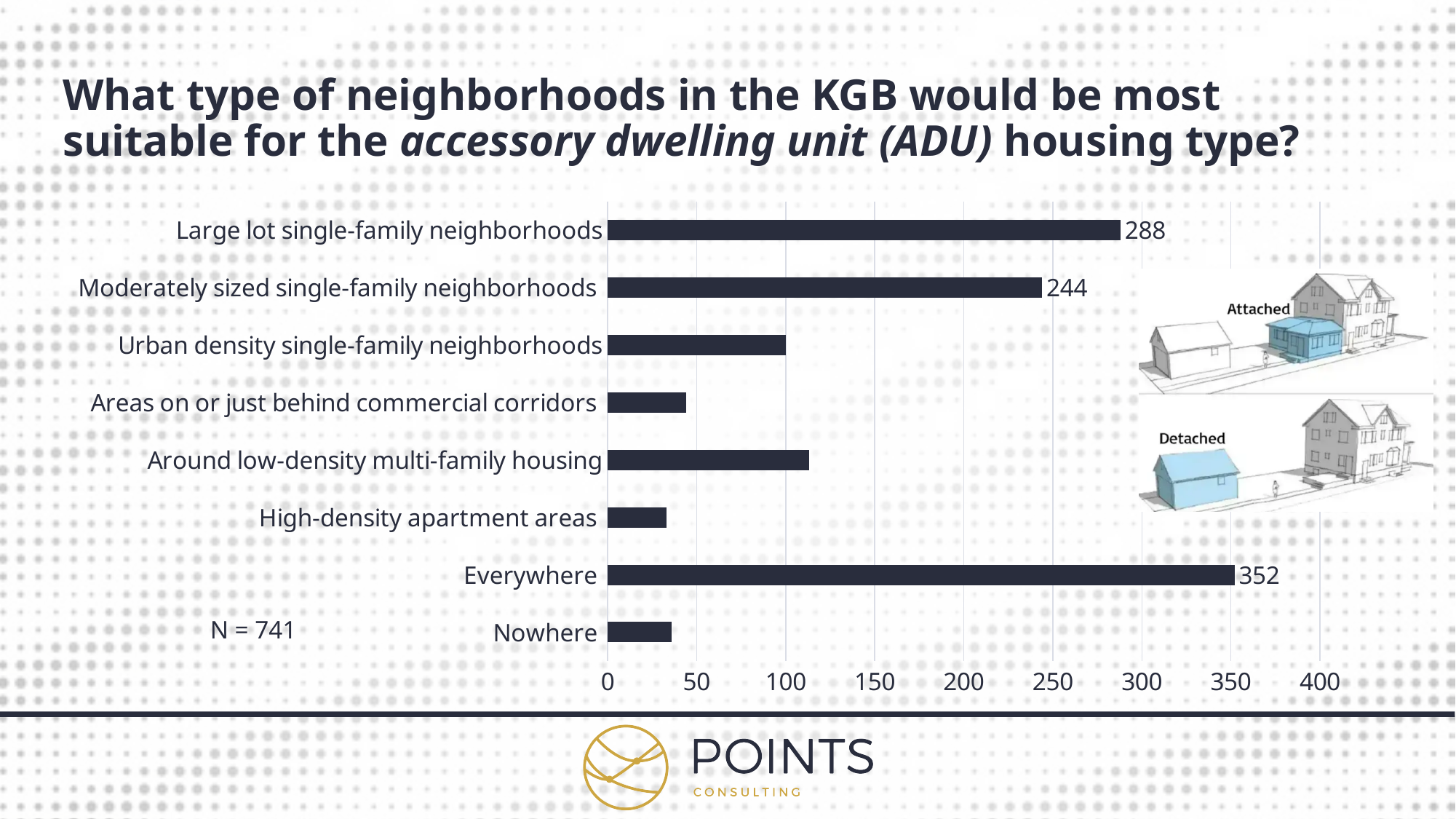
What is the value for Everywhere? 352 What is the value for Large lot single-family neighborhoods? 288 Which is larger, the value for Around low-density multi-family housing or the value for Areas on or just behind commercial corridors? Around low-density multi-family housing What is the sample size (N) stated on the slide? N = 741 What kind of chart is shown on the slide? bar chart Is the value for Areas on or just behind commercial corridors greater or less than 100? less Is the value for Urban density single-family neighborhoods greater or less than 150? less What is the difference between the values for Large lot single-family neighborhoods and Moderately sized single-family neighborhoods? 44 What is the value for Moderately sized single-family neighborhoods? 244 How many categories are shown in the chart? 8 Which category has the highest value? Everywhere What is the difference between the values for Everywhere and Large lot single-family neighborhoods? 64